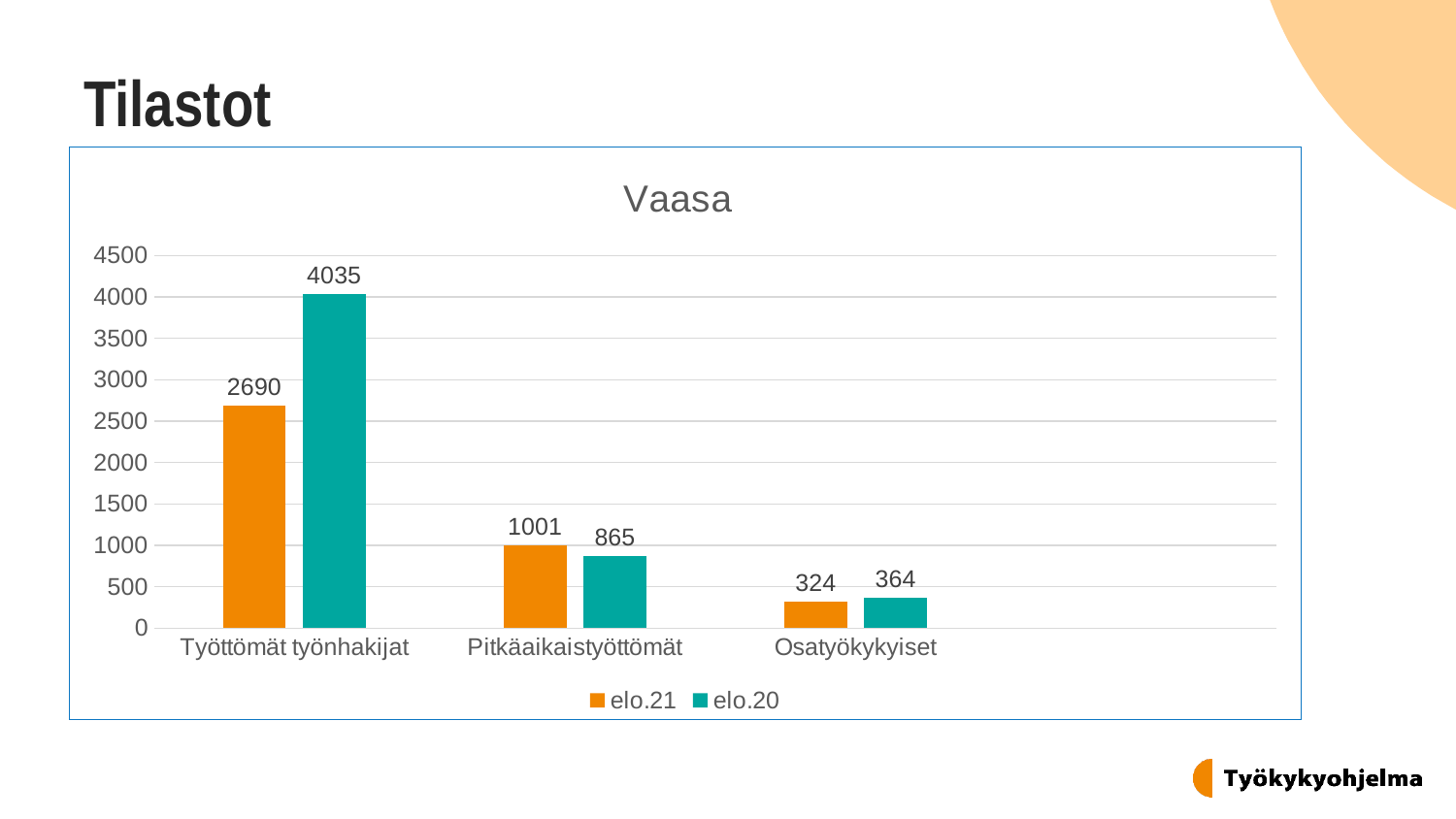
Which category has the lowest value in the elo.21 series? Osatyökykyiset What is the value for Työttömät työnhakijat in the elo.20 series? 4035 Which category has the highest value in the elo.20 series? Työttömät työnhakijat How many categories are shown on the x axis? 3 How many series does the legend list? 2 What is the value for Osatyökykyiset in the elo.20 series? 364 What is the value for Työttömät työnhakijat in the elo.21 series? 2690 What is the difference between the elo.20 and elo.21 values for Työttömät työnhakijat? 1345 What is the value for Pitkäaikaistyöttömät in the elo.21 series? 1001 Which is larger for Pitkäaikaistyöttömät, the elo.21 value or the elo.20 value? elo.21 What is the title of the chart? Vaasa What kind of chart is shown on the slide? Bar chart